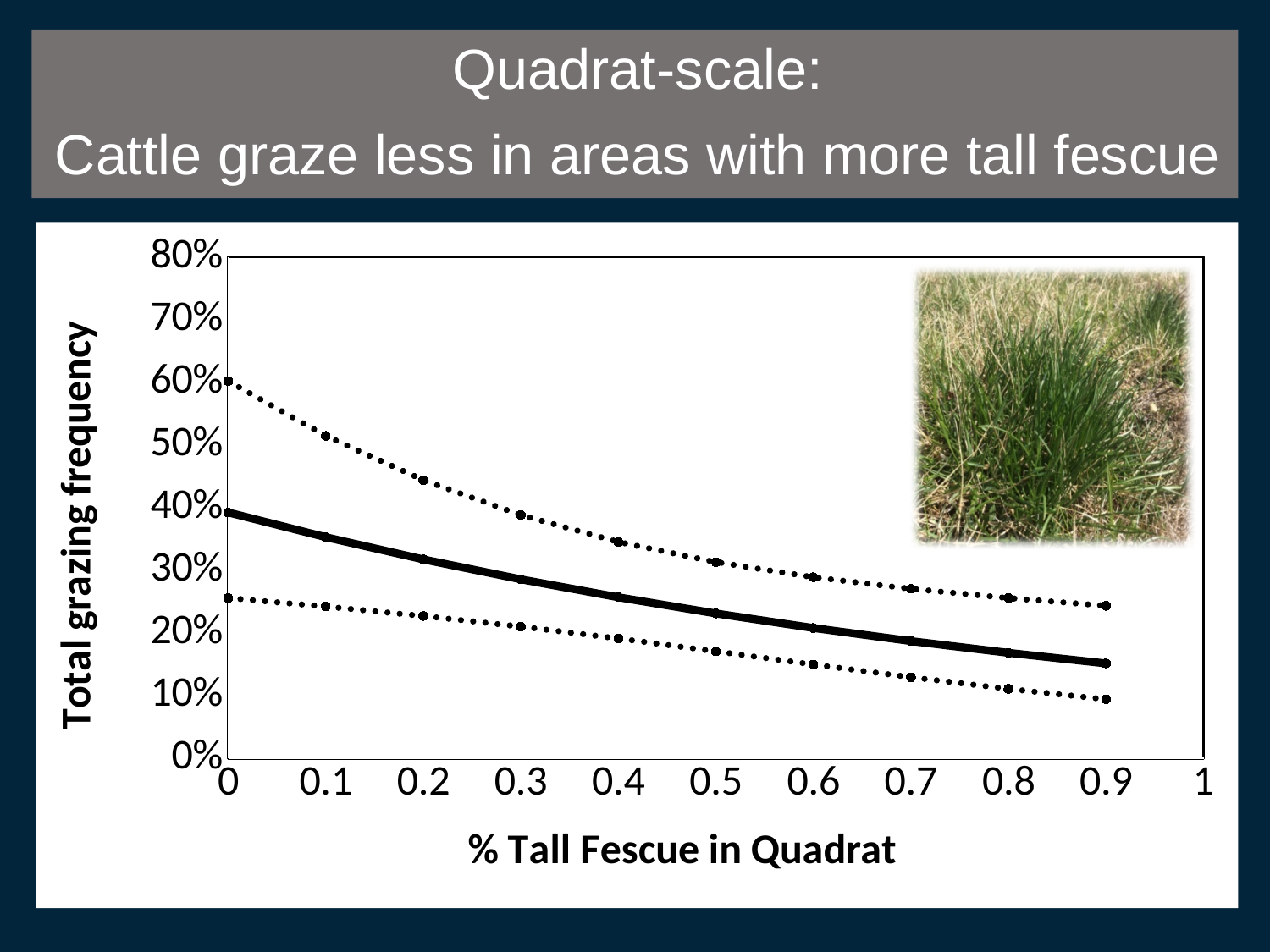
Is the value of the solid line at 0.9 on the x axis greater or less than 20%? less Is the value of the lower dotted line at 0.9 on the x axis greater or less than 20%? less What kind of chart is shown on the slide? line chart What is the highest value shown on the y axis? 80% How many lines are plotted on the chart? 3 Is the value of the solid line at 0.5 on the x axis greater or less than 30%? less What is the title of the x axis? % Tall Fescue in Quadrat Does the solid line rise or fall as % Tall Fescue in Quadrat increases? fall